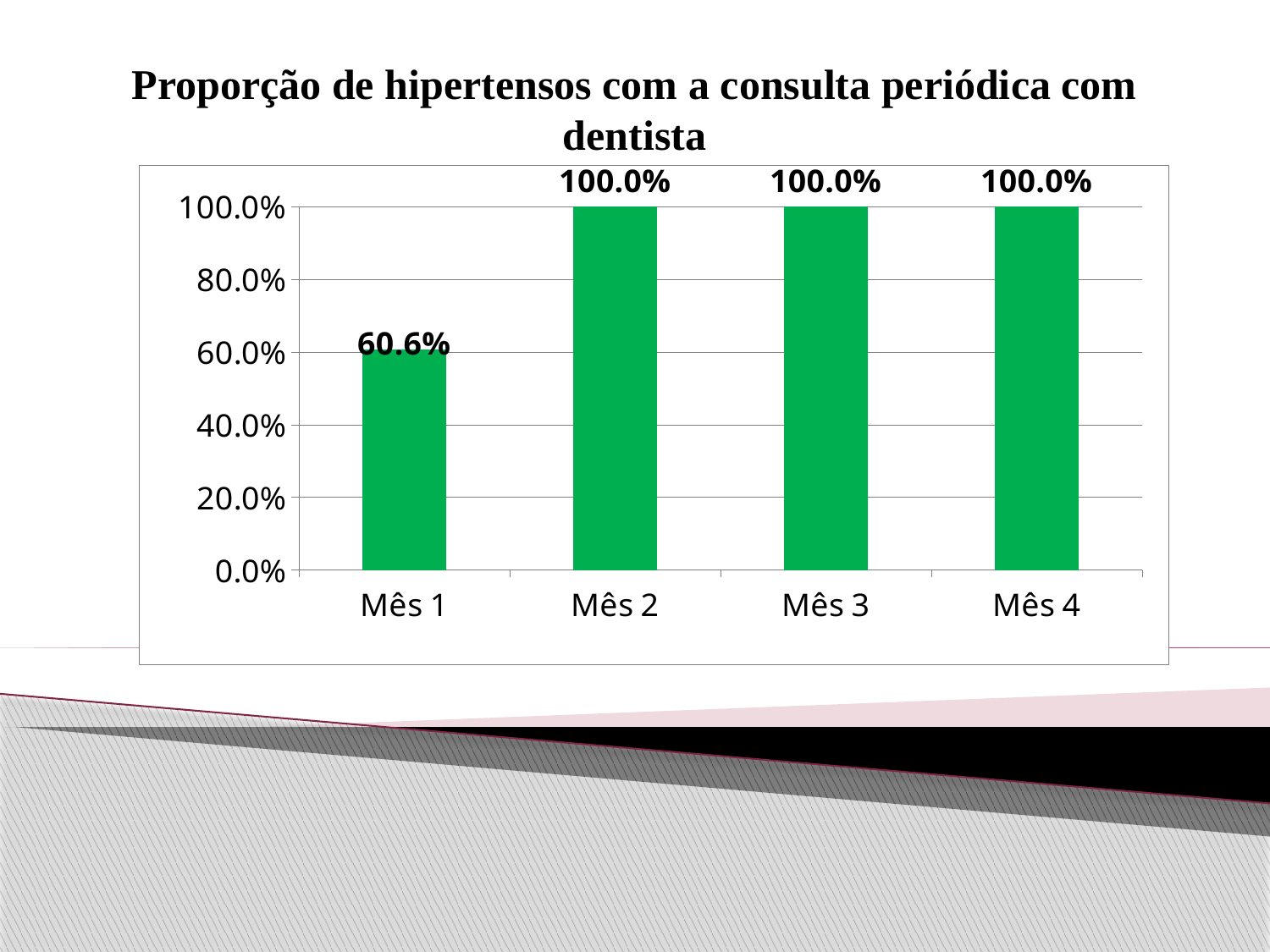
Which is larger, the value for Mês 1 or the value for Mês 4? Mês 4 What is the value for Mês 1? 60.6% Is the value for Mês 1 greater or less than 80.0%? less Do the values rise or fall from Mês 1 to Mês 2? rise How many months are shown on the x axis? 4 What is the title of the chart? Proporção de hipertensos com a consulta periódica com dentista Which month has the lowest value? Mês 1 What colour are the bars in the chart? green What is the value for Mês 3? 100.0% What is the difference between the values for Mês 2 and Mês 1? 39.4% What kind of chart is shown on the slide? bar chart How many months have a value of 100.0%? 3